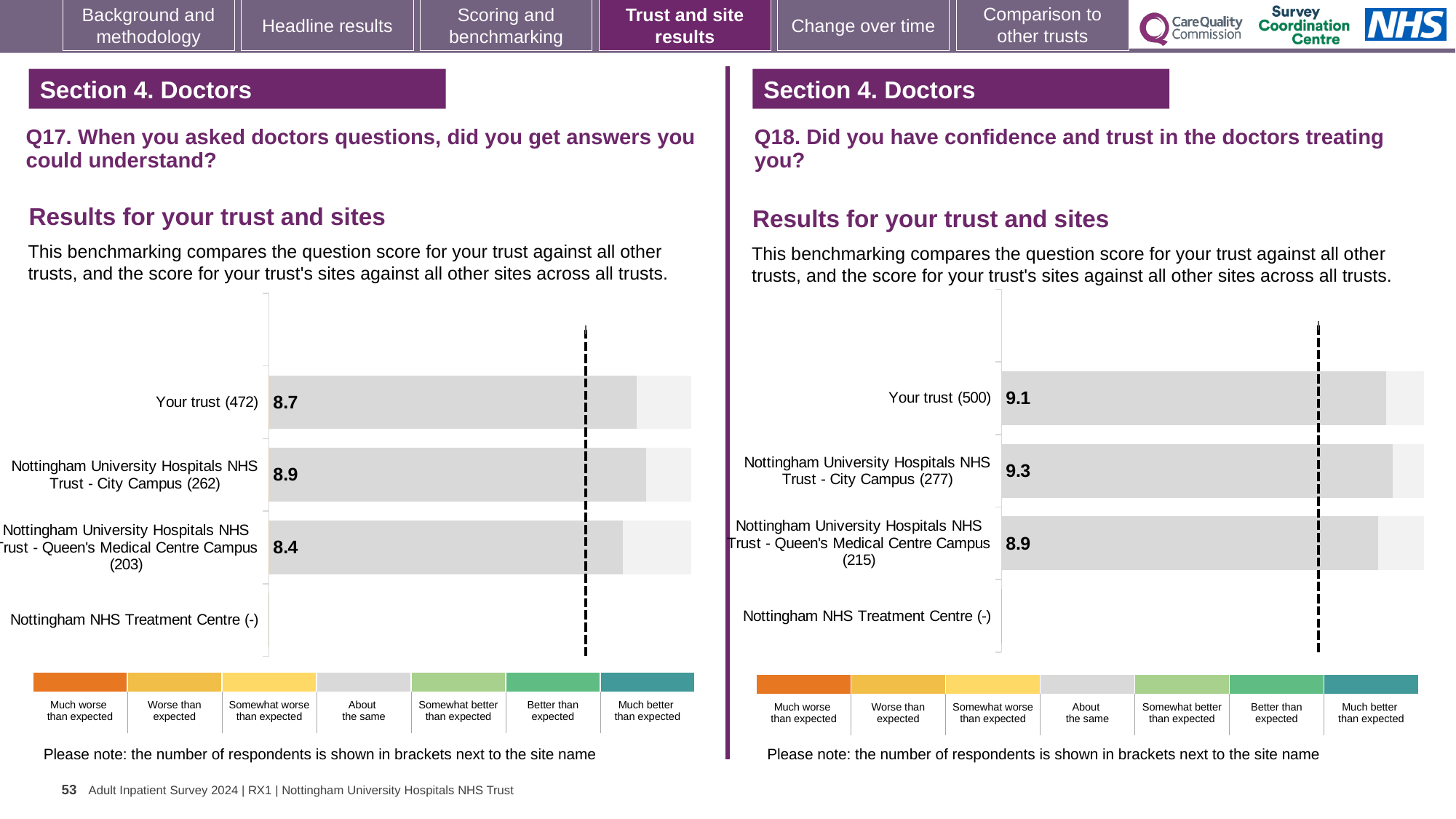
In the Q18 chart on the right, what is the score for Nottingham University Hospitals NHS Trust - Queen's Medical Centre Campus (215)? 8.9 In the Q18 chart on the right, which row has the highest score shown? Nottingham University Hospitals NHS Trust - City Campus (277) In the Q18 chart on the right, what is the score for Nottingham University Hospitals NHS Trust - City Campus (277)? 9.3 In the Q18 chart on the right, is the score for Your trust larger or smaller than the score for the Queen's Medical Centre Campus? larger In the Q17 chart on the left, which site or trust row has the lowest score shown? Nottingham University Hospitals NHS Trust - Queen's Medical Centre Campus (203) In the Q17 chart on the left, what is the score for Your trust (472)? 8.7 In the Q18 chart on the right, what is the score for Your trust (500)? 9.1 In the Q17 chart on the left, what is the score for Nottingham University Hospitals NHS Trust - Queen's Medical Centre Campus (203)? 8.4 In the Q17 chart on the left, what is the score for Nottingham University Hospitals NHS Trust - City Campus (262)? 8.9 In the Q17 chart on the left, what is the difference between the City Campus score and the Queen's Medical Centre Campus score? 0.5 What kind of chart is used for the Q18 results on the right? bar chart How many rows (trust and sites) are listed on the vertical axis of the Q17 chart on the left? 4